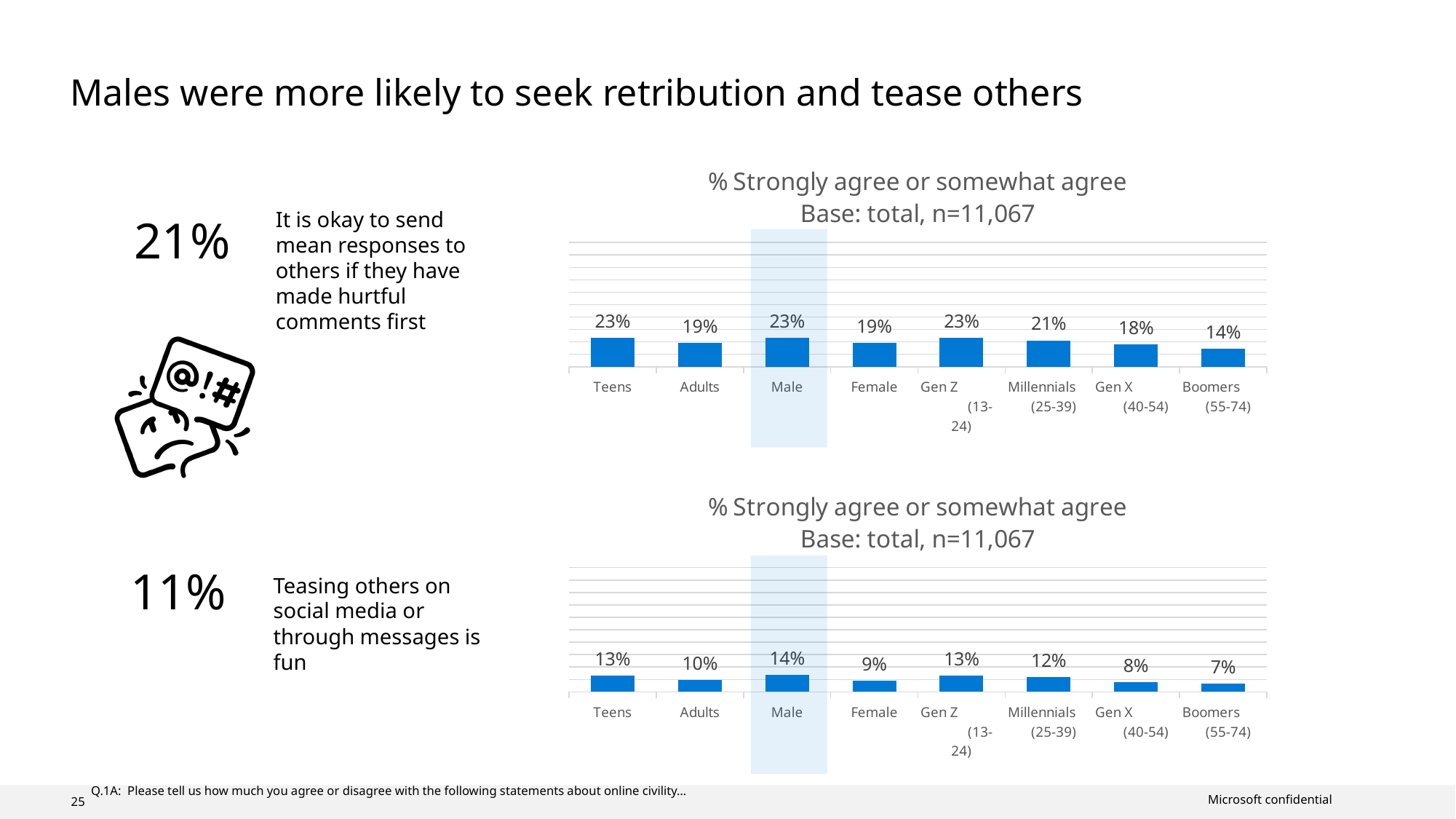
In the top chart, what is the value for Boomers (55-74)? 14% In the top chart, what is the difference between the values for Male and Female? 4% In the bottom chart, which category has the highest value? Male How many categories are shown in the top chart? 8 In the bottom chart, which category has the lowest value? Boomers (55-74) What type of chart is the bottom chart? Bar chart In the top chart, what is the value for Millennials (25-39)? 21% In the bottom chart, what is the difference between the values for Teens and Gen X (40-54)? 5% In the bottom chart, what is the value for Male? 14% In the top chart, which category has the lowest value? Boomers (55-74) In the bottom chart, what is the value for Female? 9% In the bottom chart, which is larger, the value for Adults or the value for Millennials (25-39)? Millennials (25-39)